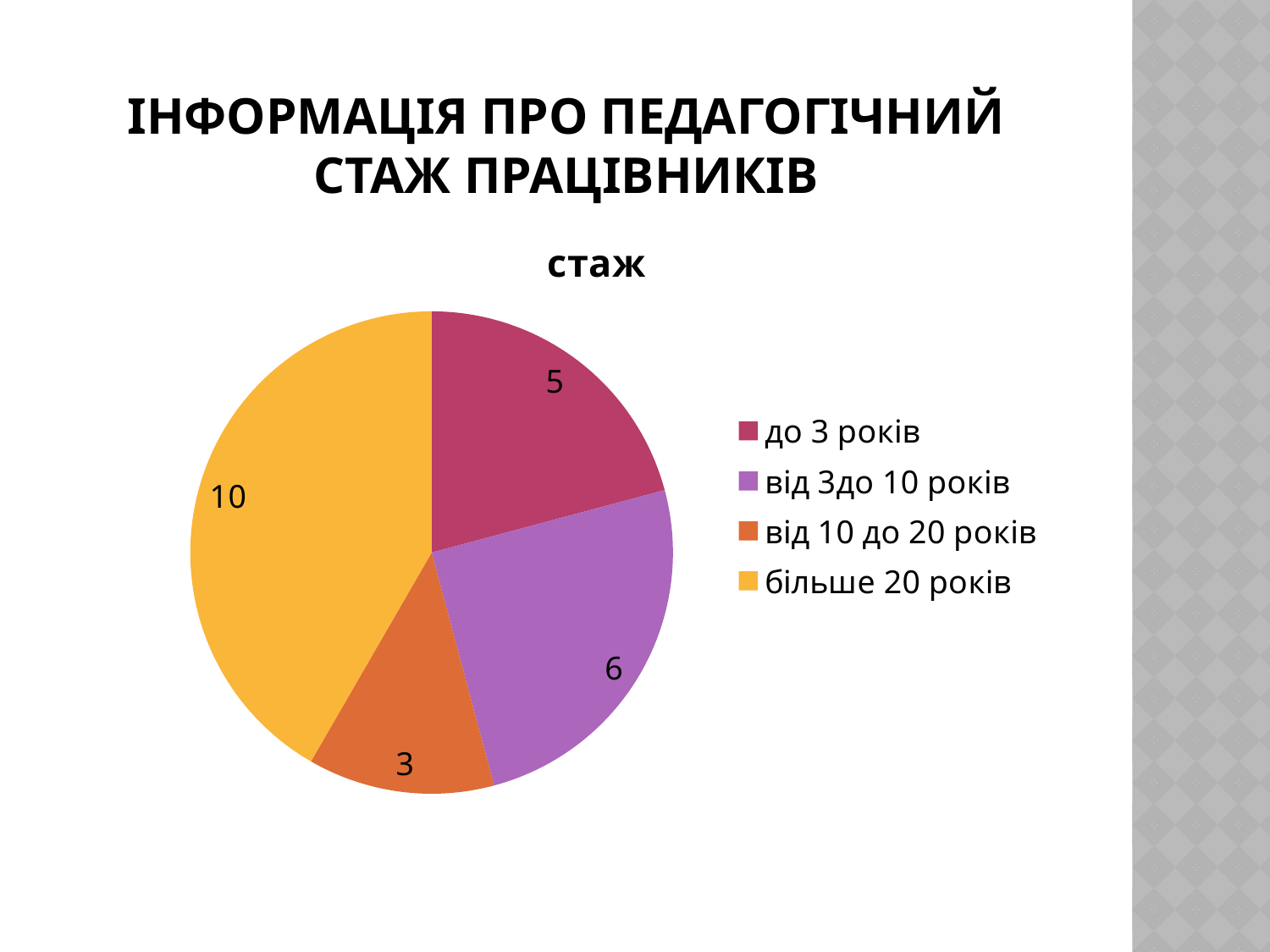
What is the value for the slice "від 3до 10 років"? 6 How many slices does the pie chart have? 4 What is the difference between the values for "більше 20 років" and "від 10 до 20 років"? 7 What is the value for the slice "до 3 років"? 5 Which category has the smallest slice of the pie? від 10 до 20 років Which category has the largest slice of the pie? більше 20 років Which is larger, the value for "від 3до 10 років" or the value for "до 3 років"? від 3до 10 років What is the title of the pie chart? стаж What type of chart is shown on the slide? pie chart What is the value for the slice "більше 20 років"? 10 What share of the pie does the slice "від 3до 10 років" represent? 25% What is the value for the slice "від 10 до 20 років"? 3